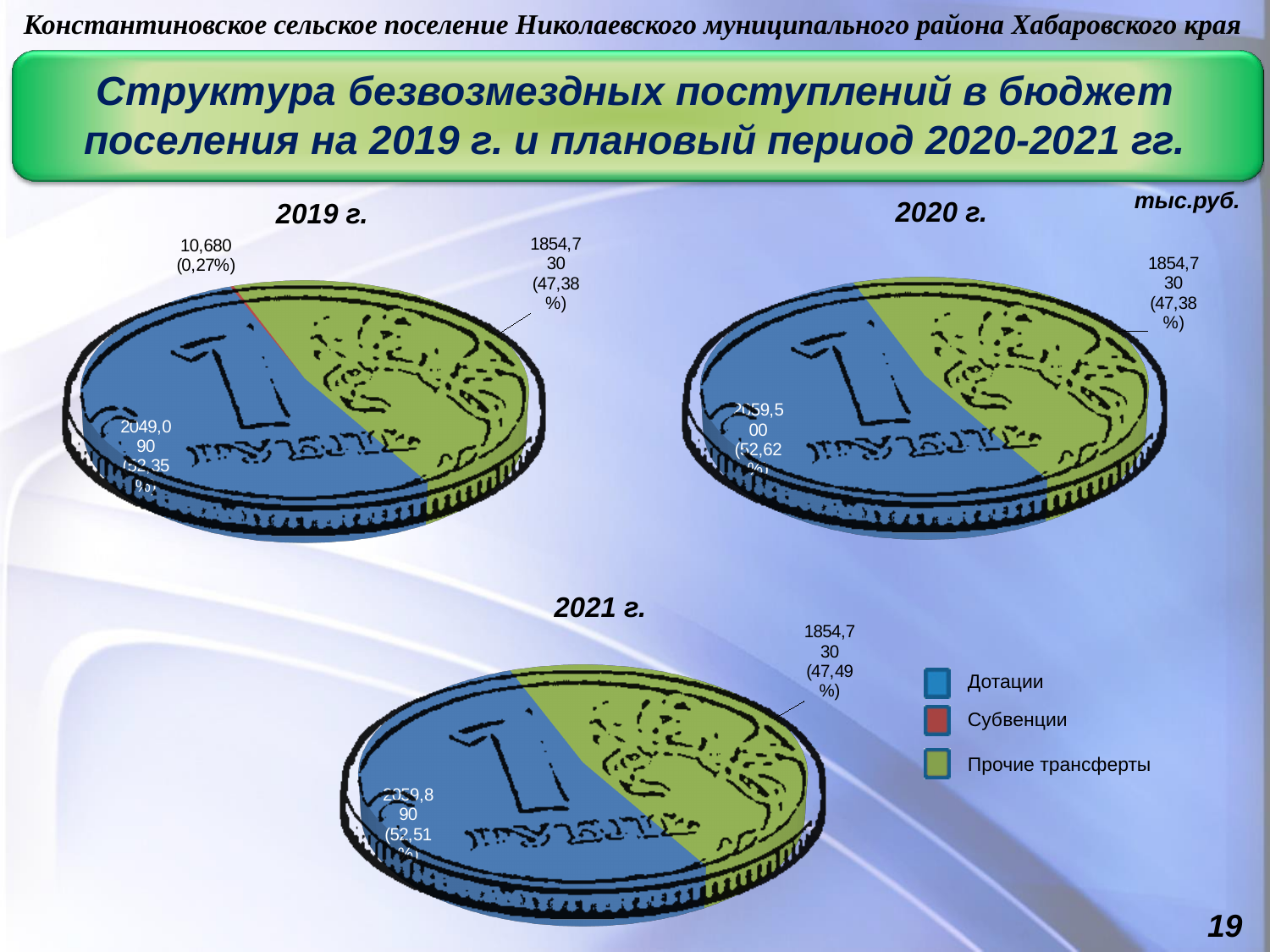
In the 2021 г. chart, what share of the total is Прочие трансферты? 47,49% What kind of chart is used to show the 2019 г. data? pie chart In the 2019 г. chart, what share of the total is Субвенции? 0,27% In the 2019 г. chart, which category has the smallest share? Субвенции What unit of measurement is indicated for the charts on the slide? тыс.руб. In the 2019 г. chart, which is larger: Дотации or Прочие трансферты? Дотации In the 2019 г. chart, what is the value for Субвенции? 10,680 How many entries does the legend list? 3 In the 2020 г. chart, what share of the total is Прочие трансферты? 47,38% In the 2021 г. chart, what is the value for Прочие трансферты? 1854,730 In the 2019 г. chart, what is the value for Прочие трансферты? 1854,730